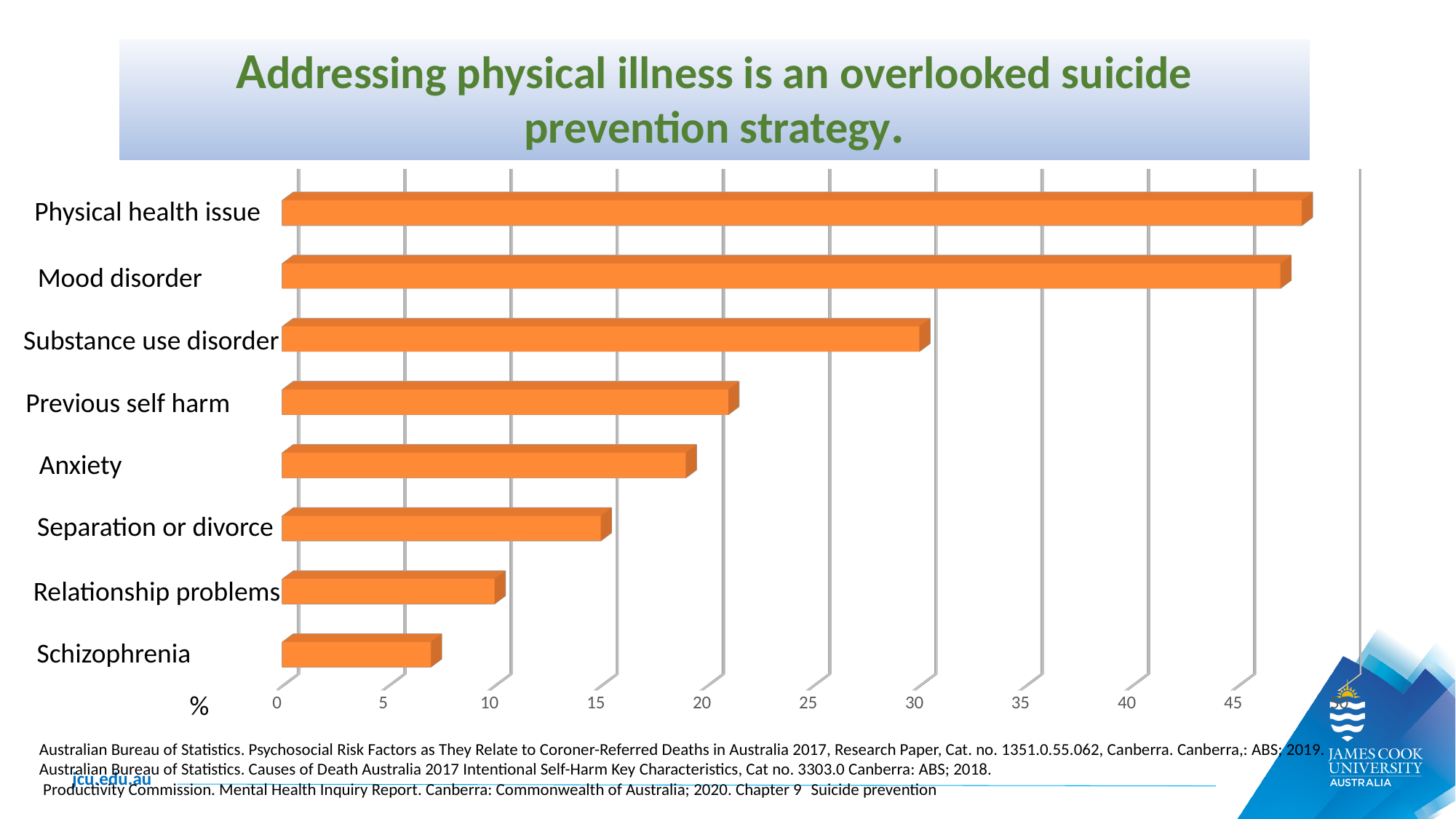
Which is larger, the value for Relationship problems or the value for Schizophrenia? Relationship problems Which category has the lowest value in the chart? Schizophrenia What kind of chart is shown on the slide? Bar chart What unit is shown on the horizontal axis of the chart? % Is the value for Relationship problems greater or less than 15? less How many categories are plotted in the chart? 8 Is the value for Schizophrenia greater or less than 10? less Is the value for Mood disorder greater or less than 40? greater Which is larger, the value for Substance use disorder or the value for Previous self harm? Substance use disorder Which is larger, the value for Anxiety or the value for Separation or divorce? Anxiety